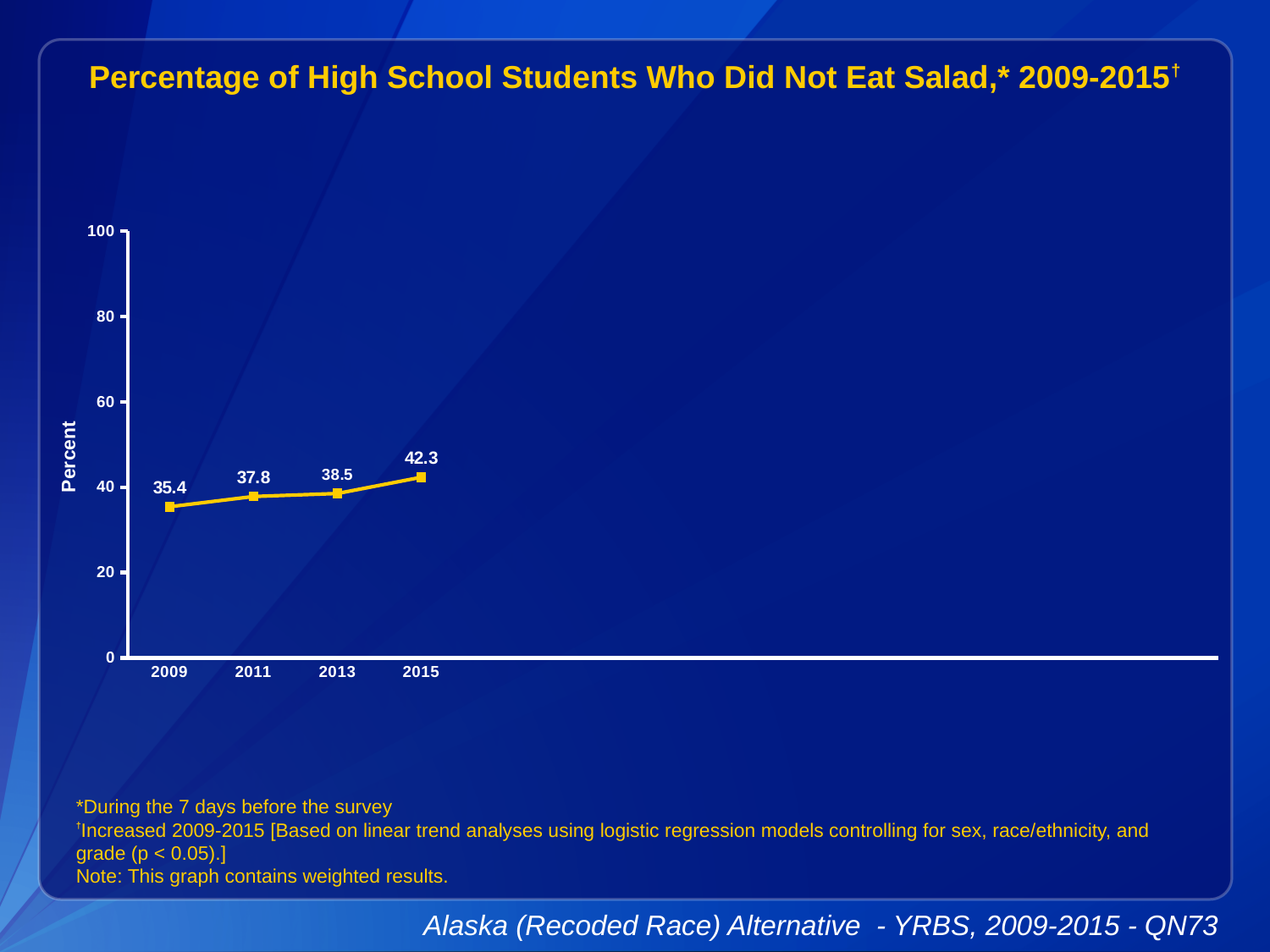
What is the label on the vertical axis? Percent What is the value plotted for 2011? 37.8 Which is larger, the value for 2013 or the value for 2011? 2013 What percentage of high school students did not eat salad in 2009? 35.4 Which year has the lowest percentage of students who did not eat salad? 2009 What is the value plotted for 2015? 42.3 Do the values rise or fall from 2009 to 2015? rise Which year has the highest percentage of students who did not eat salad? 2015 What kind of chart is shown on the slide? line chart What is the difference between the 2015 value and the 2009 value? 6.9 How many years are plotted on the chart? 4 Is the value for 2015 greater or less than 40? greater